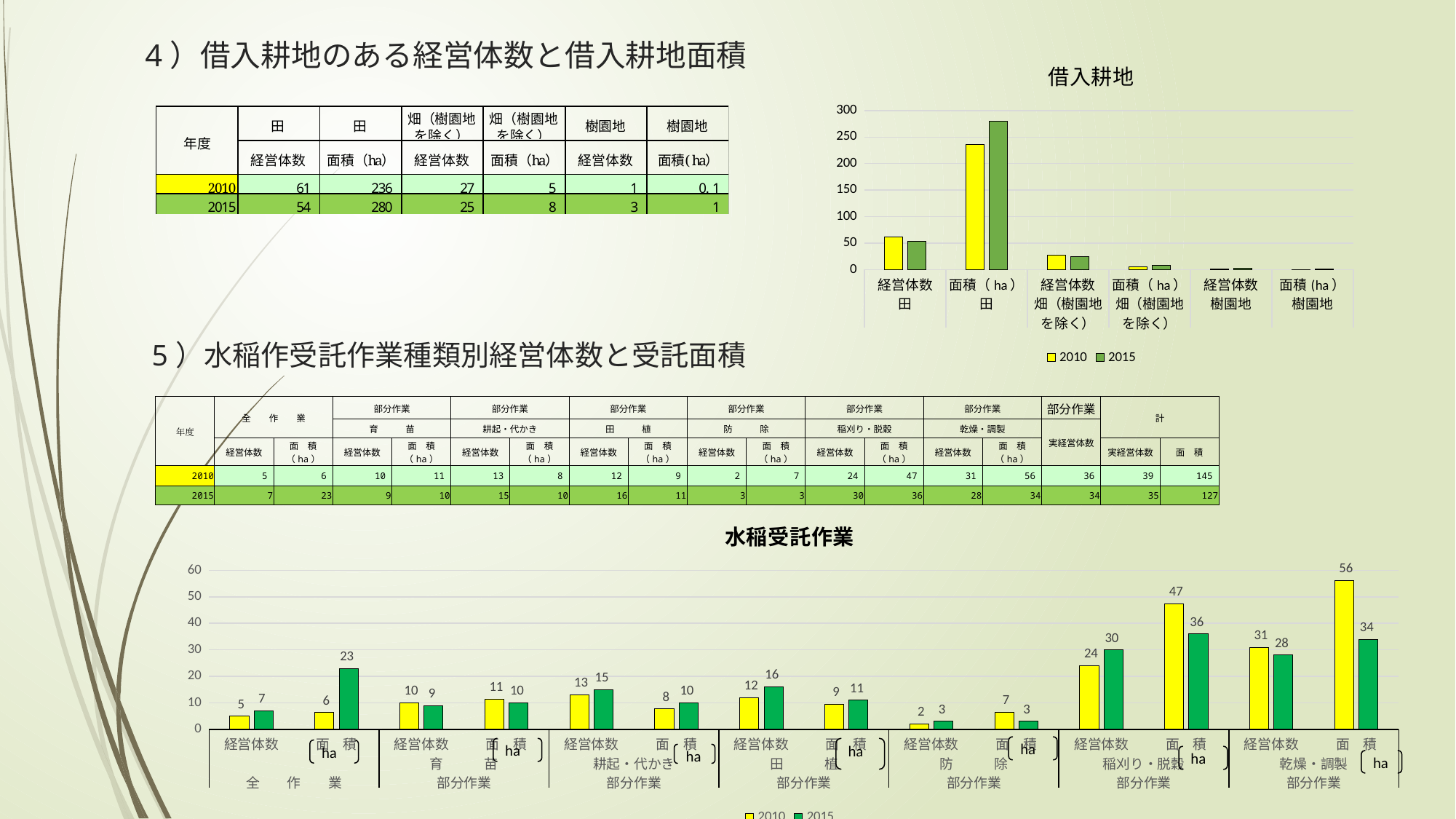
In the 水稲受託作業 chart, what is the 2010 value for 面積 (ha) under 乾燥・調製? 56 In the 水稲受託作業 chart, what is the 2015 value for 経営体数 under 稲刈り・脱穀? 30 In the 借入耕地 chart, which bar is the highest? 2015 面積 (ha) 田 In the 借入耕地 chart, is the 2015 value for 面積 (ha) 田 greater or less than 250? greater In the 水稲受託作業 chart, which is larger for 経営体数 under 田植: 2010 or 2015? 2015 In the 水稲受託作業 chart, what is the 2010 value for 経営体数 under 全作業? 5 In the 水稲受託作業 chart, which bar has the highest value? 2010 面積 (ha) 乾燥・調製 In the 水稲受託作業 chart, what is the difference between the 2010 and 2015 values for 面積 (ha) under 稲刈り・脱穀? 11 In the 水稲受託作業 chart, what is the 2015 value for 面積 (ha) under 全作業? 23 In the 借入耕地 chart, is the 2010 value for 経営体数 田 greater or less than 50? greater How many series does the legend of the 水稲受託作業 chart list? 2 What kind of chart is the 借入耕地 chart? bar chart